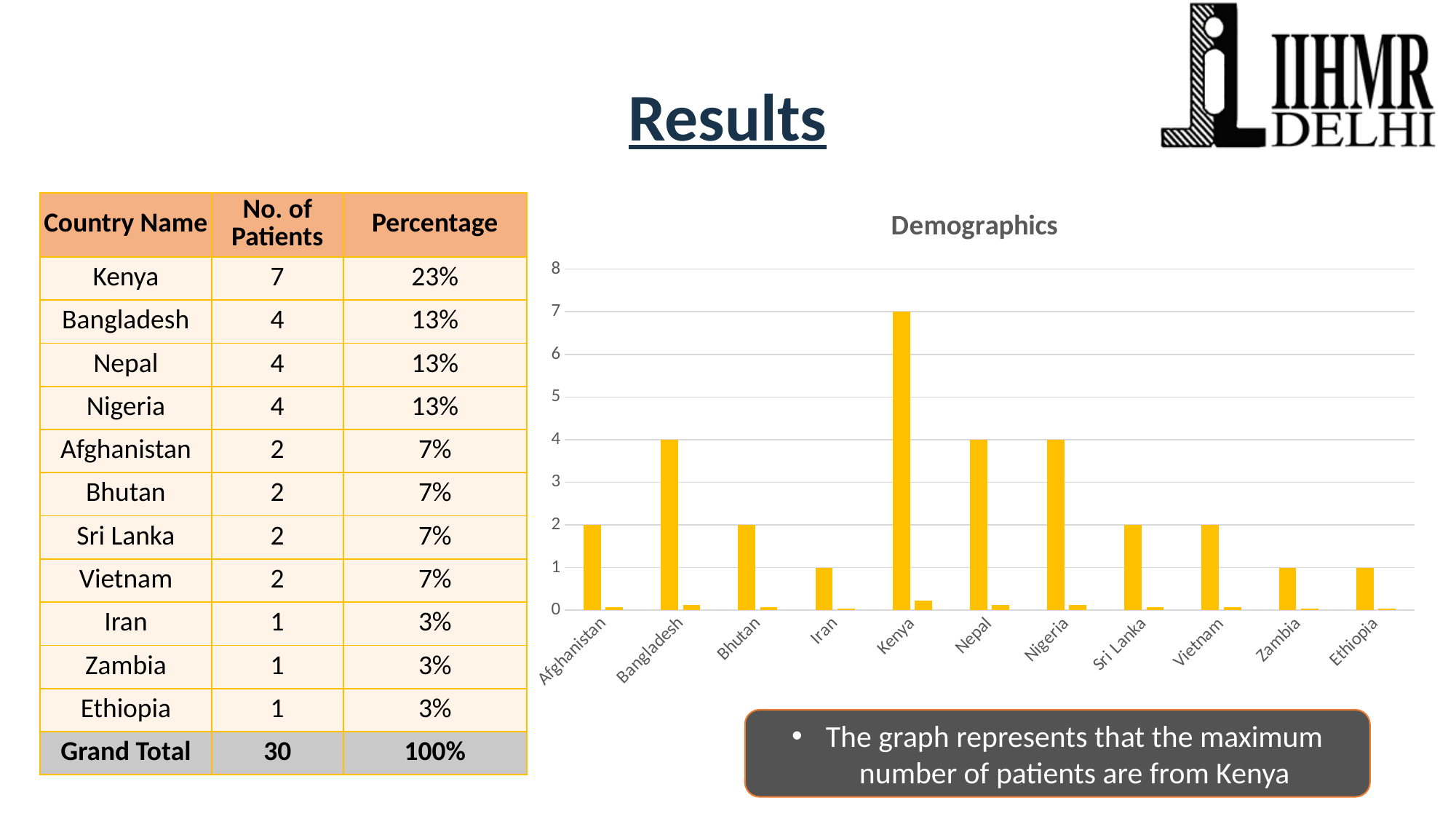
What is the title of the chart? Demographics What is the highest value shown on the y axis of the Demographics chart? 8 Is the tall bar for Kenya in the Demographics chart greater or less than 6? greater Which is larger in the Demographics chart, the tall bar for Nigeria or the tall bar for Vietnam? Nigeria How many countries are shown on the x axis of the Demographics chart? 11 What is the difference between the tall bars for Kenya and Nepal in the Demographics chart? 3 What is the value of the tall bar for Sri Lanka in the Demographics chart? 2 Which country has the highest bar in the Demographics chart? Kenya What is the value of the tall bar for Bangladesh in the Demographics chart? 4 What kind of chart is shown on the slide? Bar chart What is the value of the tall bar for Iran in the Demographics chart? 1 What is the value of the tall bar for Kenya in the Demographics chart? 7